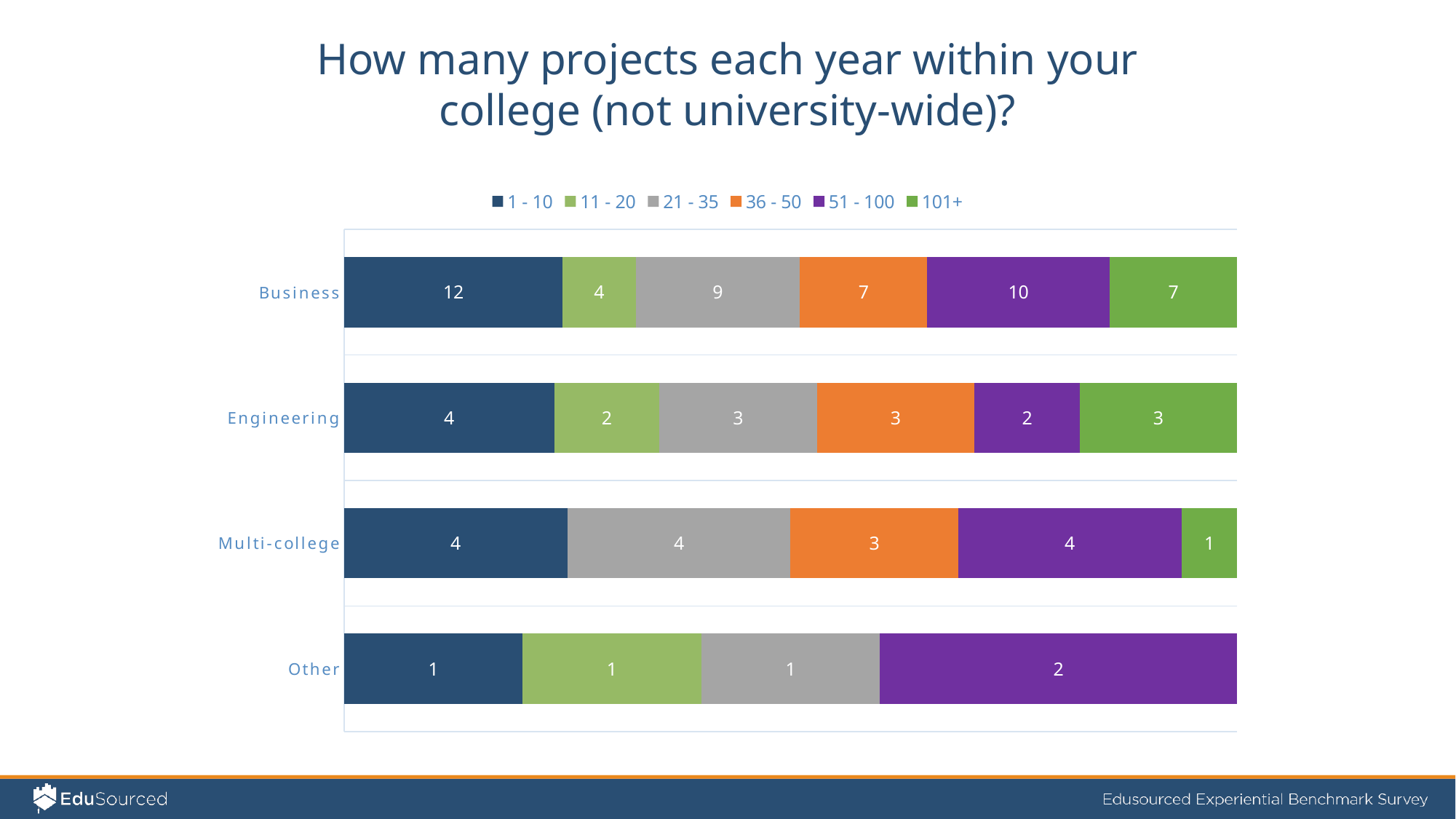
Which series has the lowest value in the Multi-college category? 101+ How many series does the legend list? 6 What is the value for the 36 - 50 series in the Engineering category? 3 What is the value for the 51 - 100 series in the Other category? 2 What kind of chart is shown on the slide? Stacked bar chart What is the value for the 51 - 100 series in the Multi-college category? 4 Which series has the highest value in the Business category? 1 - 10 In the Business category, which is larger: the 21 - 35 value or the 36 - 50 value? 21 - 35 What is the value for the 1 - 10 series in the Business category? 12 How many categories are shown on the y axis? 4 What is the total of all segments in the Engineering bar? 17 What is the difference between the 1 - 10 value and the 11 - 20 value in the Business category? 8